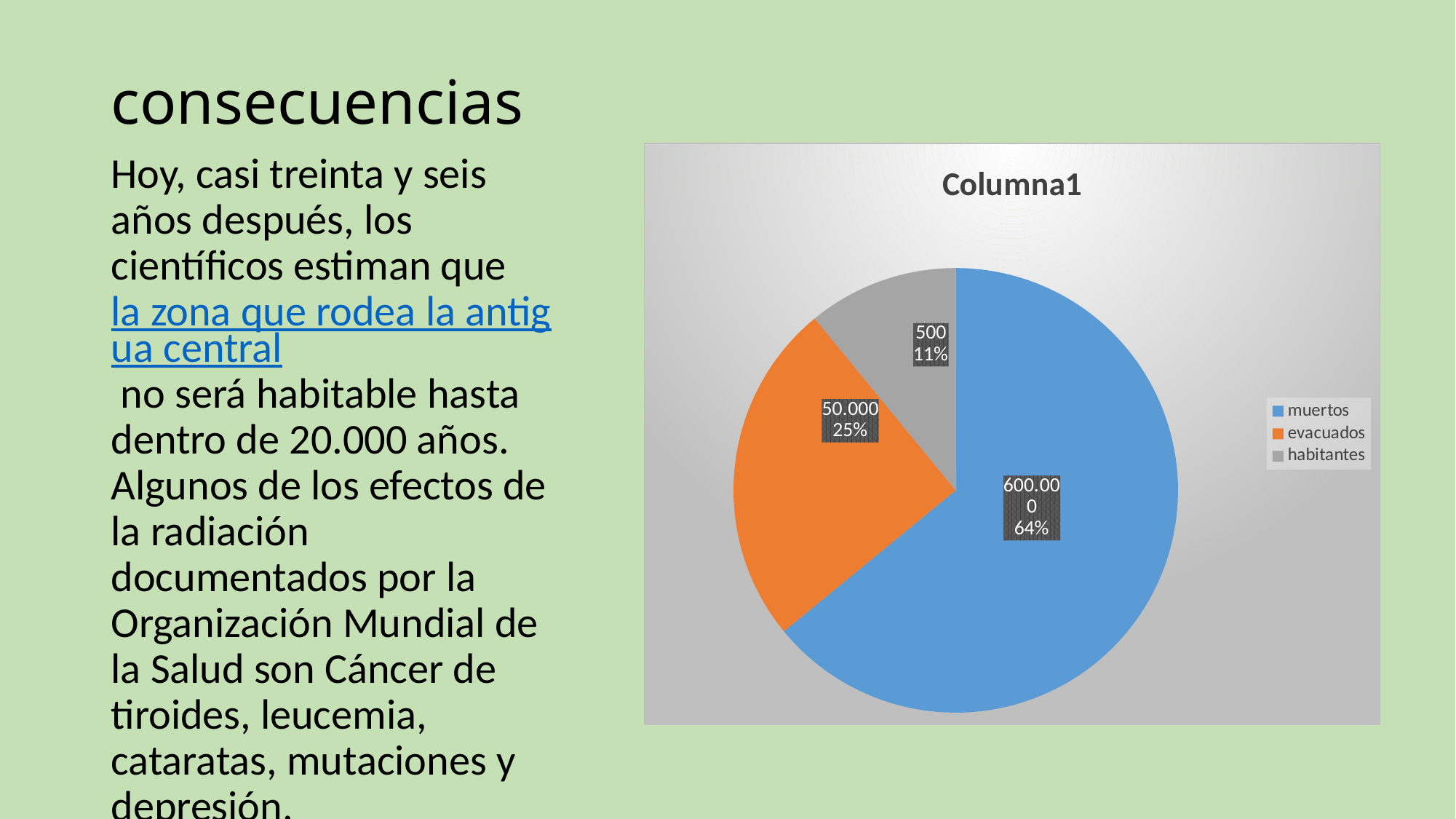
What percentage share of the pie is labelled for habitantes? 11% What kind of chart is shown on the slide? pie chart How many slices does the pie chart have? 3 Which colour represents evacuados in the legend? orange What is the title of the chart? Columna1 What percentage share of the pie is labelled for evacuados? 25% Which category has the largest slice of the pie? muertos What percentage share of the pie is labelled for muertos? 64% What value is shown for the muertos slice? 600.000 What value is shown for the evacuados slice? 50.000 What value is shown for the habitantes slice? 500 Which category has the smallest slice of the pie? habitantes